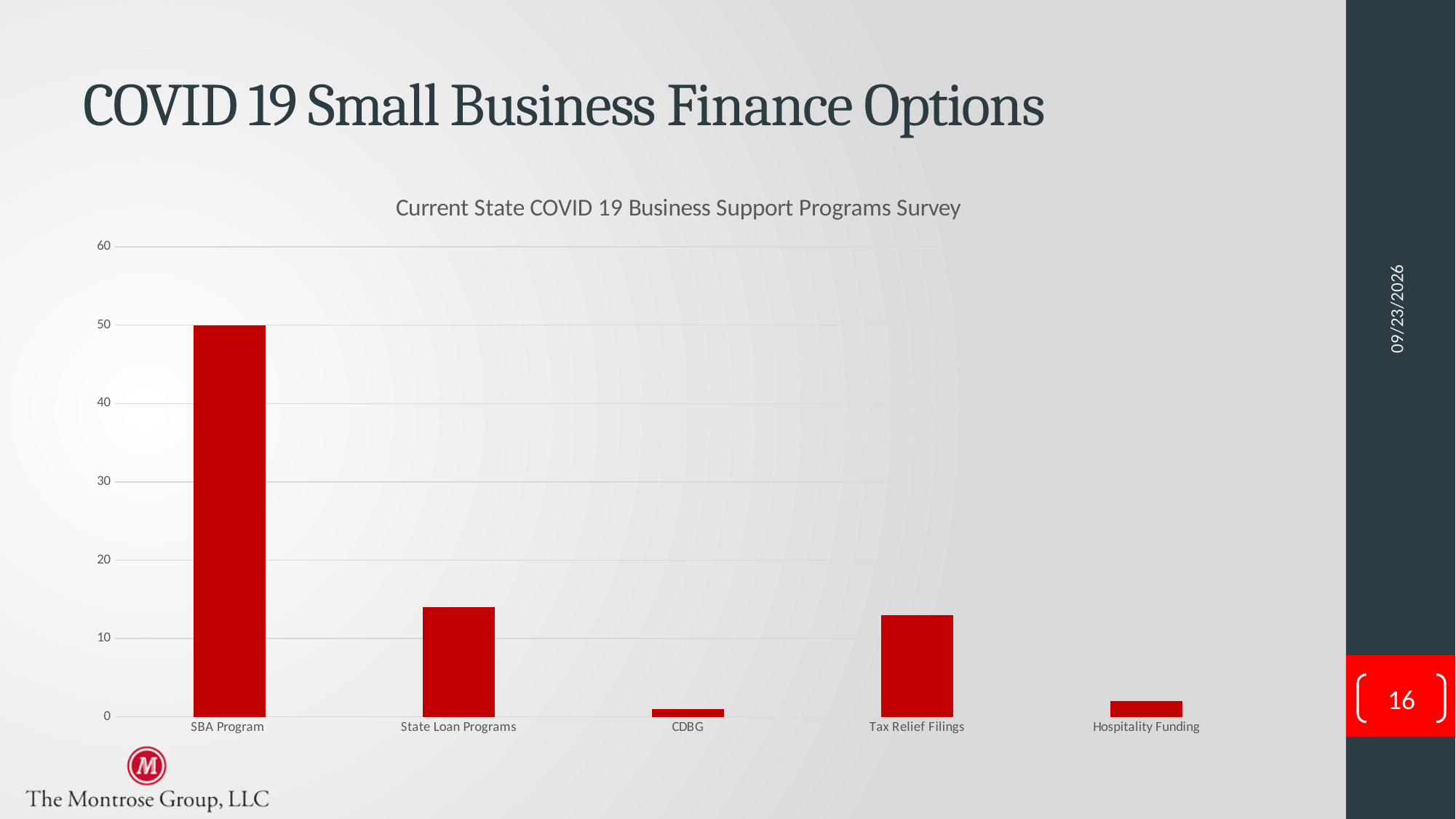
Which category has the lowest value in the chart? CDBG Which category has the highest value in the chart? SBA Program What is the title of the chart? Current State COVID 19 Business Support Programs Survey What colour are the bars in the chart? Red Which is larger, the value for SBA Program or the value for State Loan Programs? SBA Program Is the value for Tax Relief Filings greater or less than 20? less What is the value for SBA Program? 50 What kind of chart is shown on the slide? Bar chart How many categories are shown on the x axis of the chart? 5 Is the value for CDBG greater or less than 10? less Is the value for Hospitality Funding greater or less than 10? less